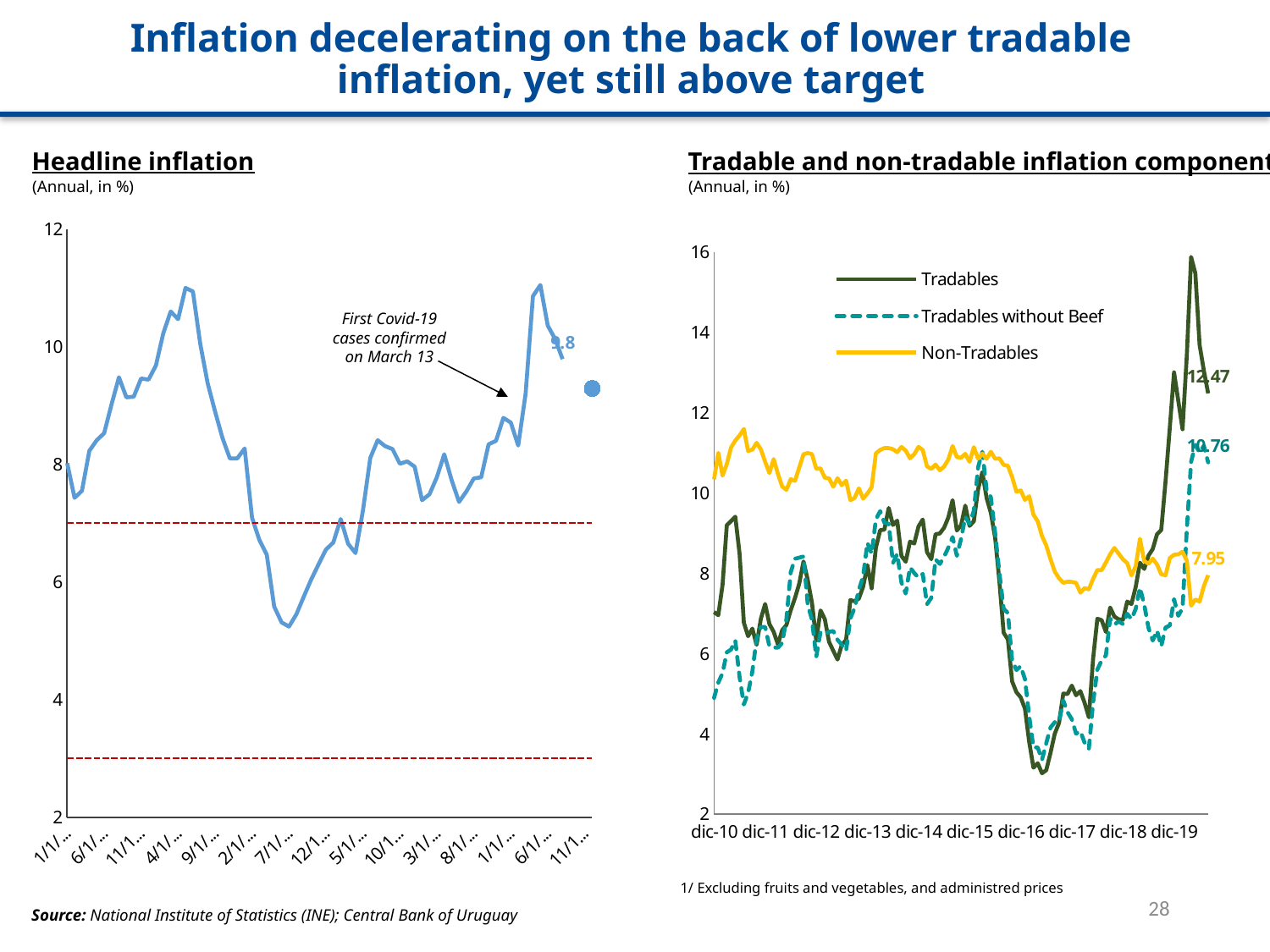
In the Tradable and non-tradable inflation components chart, what is the difference between the latest labelled values for Tradables and Tradables without Beef? 1.71 In the Tradable and non-tradable inflation components chart, what is the latest value labelled for Tradables without Beef? 10.76 In the Tradable and non-tradable inflation components chart, what colour is the Non-Tradables line? yellow In the Tradable and non-tradable inflation components chart, what is the difference between the latest labelled values for Tradables and Non-Tradables? 4.52 In the Tradable and non-tradable inflation components chart, which series has the lowest latest labelled value? Non-Tradables In the Headline inflation chart, is the peak of the line in 2020 greater or less than 10? greater How many series does the legend of the Tradable and non-tradable inflation components chart list? 3 In the Tradable and non-tradable inflation components chart, what is the latest value labelled for Non-Tradables? 7.95 What kind of chart is the Headline inflation chart? line chart In the Tradable and non-tradable inflation components chart, which series has the highest latest labelled value? Tradables In the Tradable and non-tradable inflation components chart, what is the latest value labelled for Tradables? 12.47 In the Headline inflation chart, what is the latest value labelled at the end of the line? 9.8